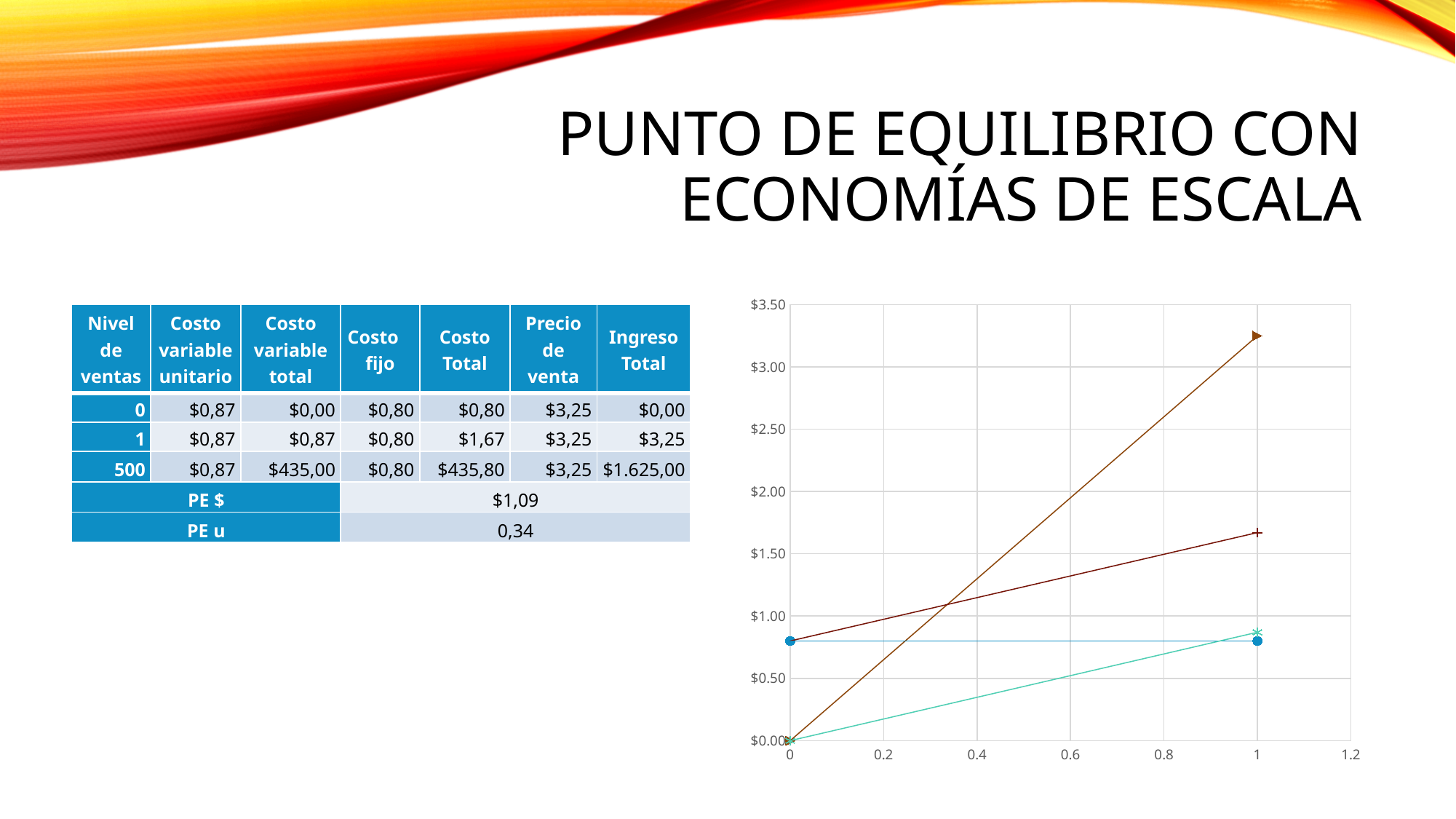
How many lines are plotted in the chart? 4 What is the highest tick label shown on the chart's y axis? $3.50 Is the value of the dark red plus-marker line at x = 1 greater or less than $1.50? greater What kind of chart is shown on the right side of the slide? line chart Does the blue circle-marker line rise, fall, or stay flat from x = 0 to x = 1? stay flat Is the value of the teal x-marker line at x = 1 greater or less than $1.00? less What is the value of the teal x-marker line at x = 0? $0.00 Does the orange triangle-marker line rise or fall from x = 0 to x = 1? rise Is the value of the blue circle-marker line at x = 0 greater or less than $0.50? greater What is the highest tick label shown on the chart's x axis? 1.2 Which line reaches the highest value at x = 1 in the chart? the orange line with the triangle marker